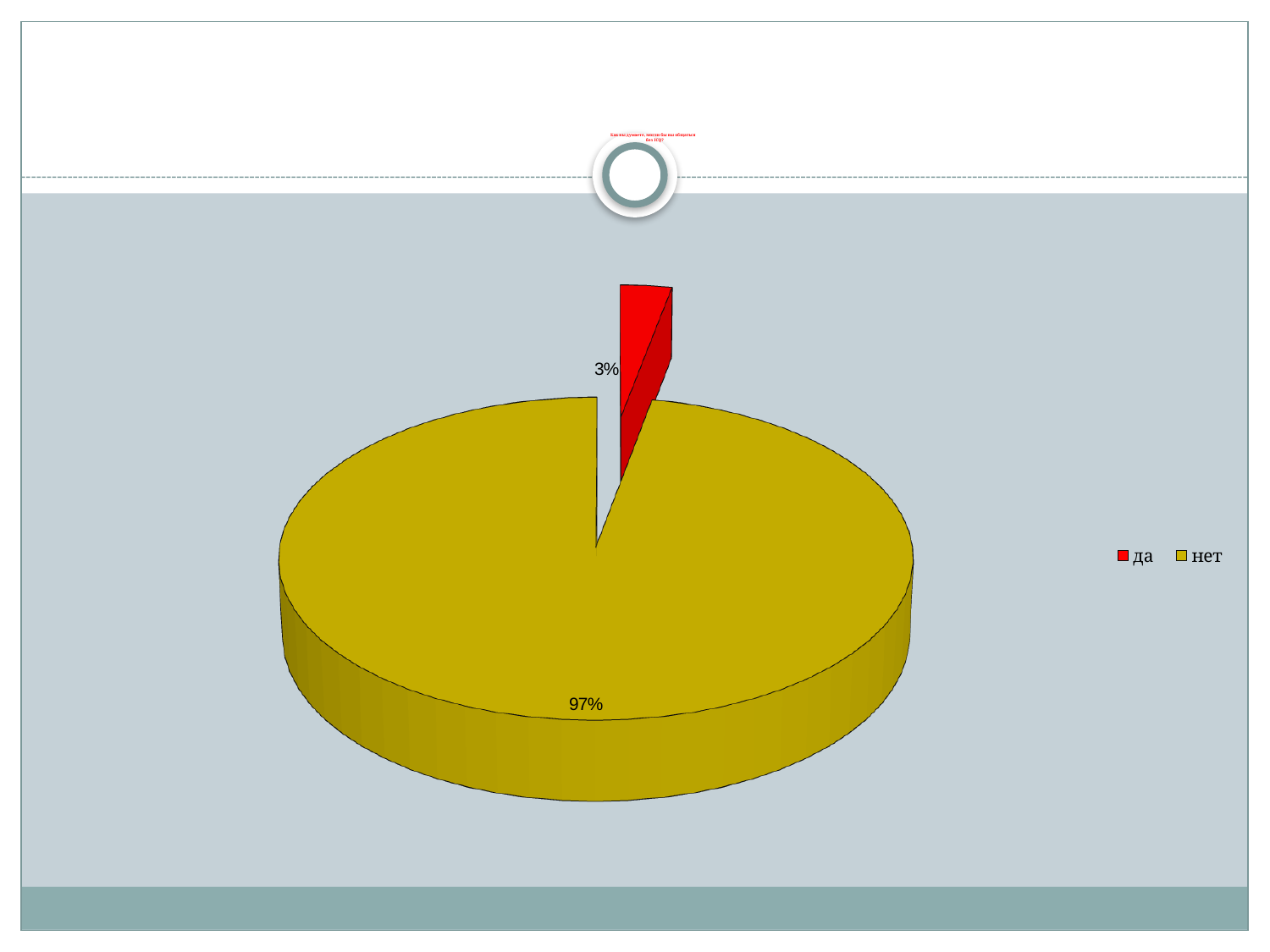
What colour is the "да" slice in the pie chart? red What colour is the "нет" slice in the pie chart? yellow What kind of chart is shown on the slide? pie chart Which slice of the pie is the smallest? да What share of the pie does the "да" slice represent? 3% What share of the pie does the "нет" slice represent? 97% How many entries does the legend list? 2 Which is larger, the share for "да" or the share for "нет"? нет Which slice of the pie is the largest? нет What is the difference in percentage points between the "нет" share and the "да" share? 94 How many slices does the pie chart have? 2